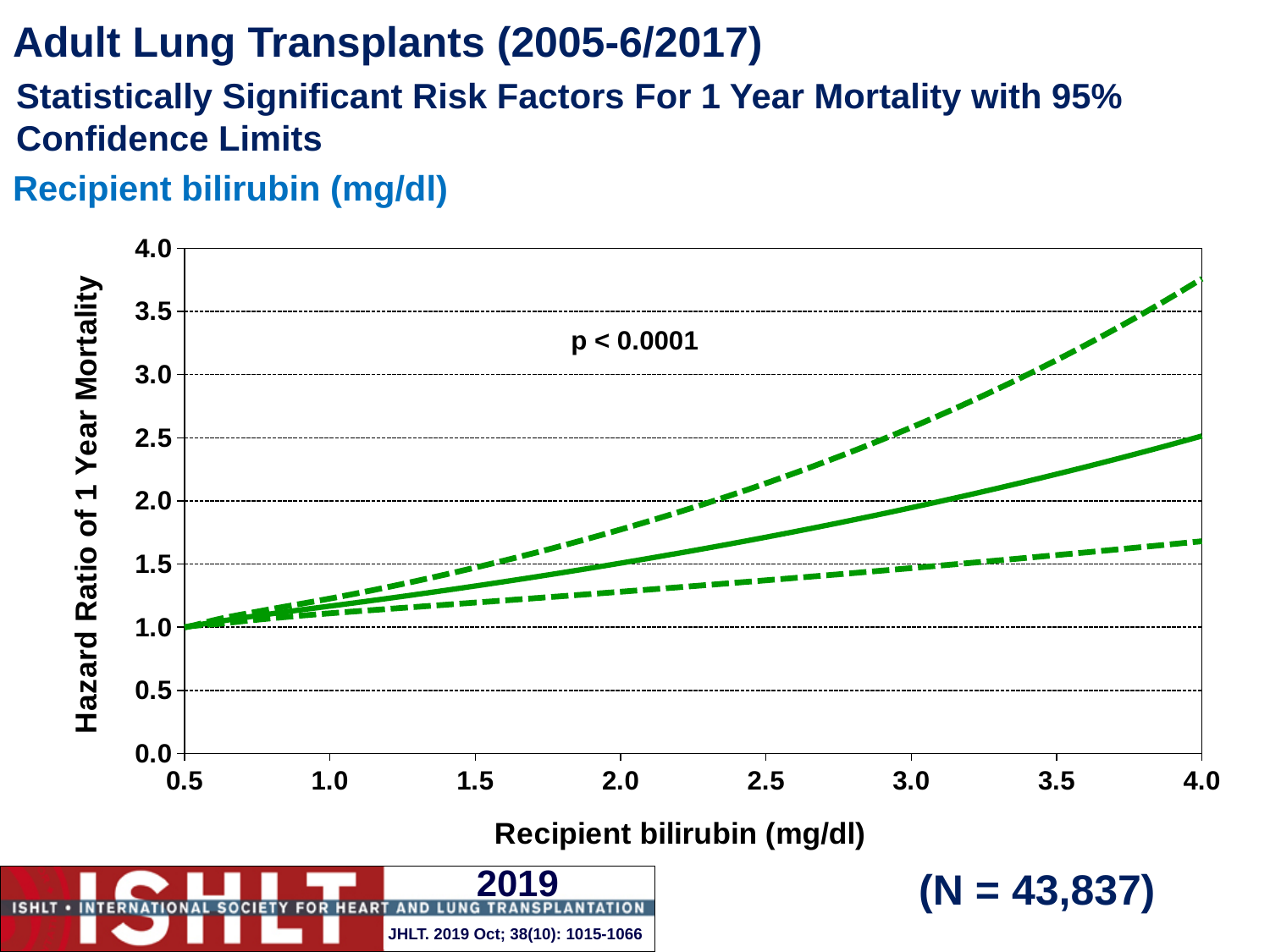
Is the hazard ratio on the solid line at a recipient bilirubin of 2.0 mg/dl greater or less than 2.0? less Is the lower dashed confidence limit at a recipient bilirubin of 4.0 mg/dl greater or less than 2.0? less What p-value is printed on the chart? p < 0.0001 Does the hazard ratio of 1 year mortality rise or fall as recipient bilirubin increases along the x axis? rise What is the hazard ratio of 1 year mortality at a recipient bilirubin of 0.5 mg/dl, where the lines start? 1.0 At a recipient bilirubin of 4.0 mg/dl, which is larger: the upper dashed confidence limit or the solid hazard ratio line? the upper dashed confidence limit How many lines are plotted on the chart? 3 What kind of chart is shown on the slide? line chart Is the upper dashed confidence limit at a recipient bilirubin of 4.0 mg/dl greater or less than 3.5? greater What is the label of the x axis? Recipient bilirubin (mg/dl)